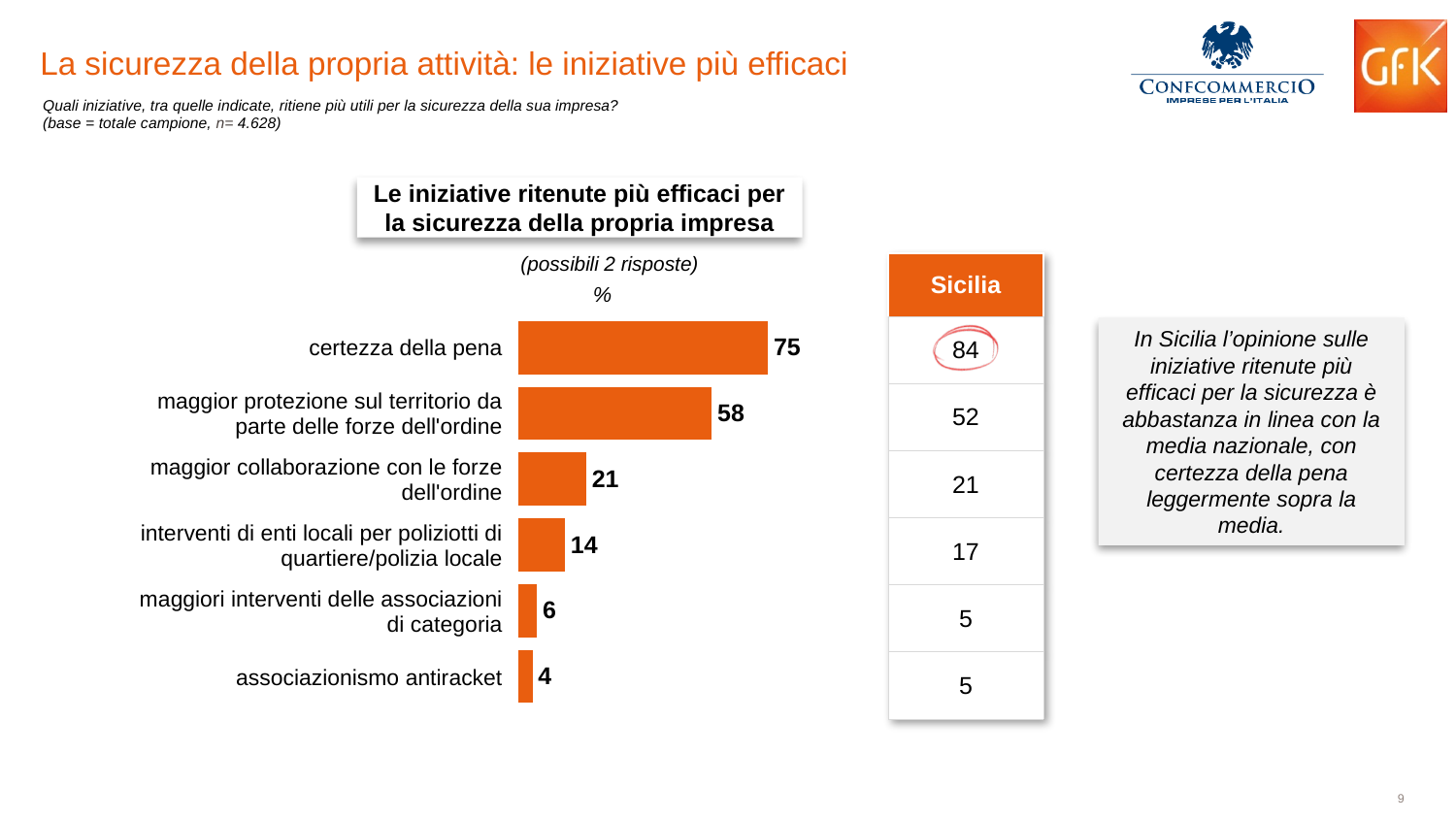
What is the difference between the values for "maggiori interventi delle associazioni di categoria" and "associazionismo antiracket"? 2 Which category has the lowest value? associazionismo antiracket How many categories does the chart show? 6 What is the value for "maggior protezione sul territorio da parte delle forze dell'ordine"? 58 Which is larger: the value for "maggior collaborazione con le forze dell'ordine" or the value for "interventi di enti locali per poliziotti di quartiere/polizia locale"? maggior collaborazione con le forze dell'ordine What is the difference between the values for "certezza della pena" and "maggior protezione sul territorio da parte delle forze dell'ordine"? 17 What is the value for "interventi di enti locali per poliziotti di quartiere/polizia locale"? 14 What is the value for "certezza della pena"? 75 Which category has the highest value? certezza della pena What kind of chart is shown on the slide? bar chart What is the value for "associazionismo antiracket"? 4 What is the title of the chart? Le iniziative ritenute più efficaci per la sicurezza della propria impresa